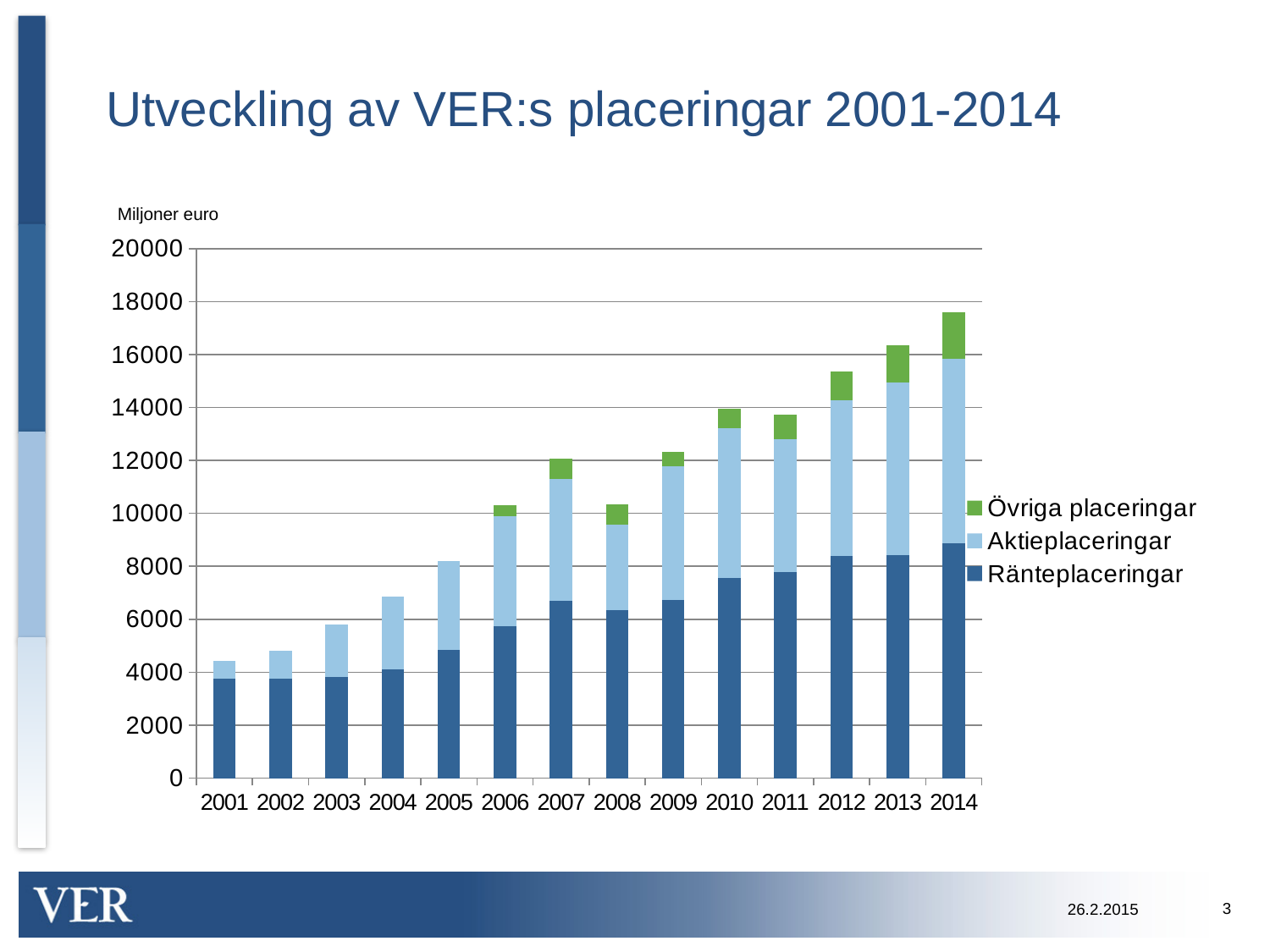
What unit is shown above the y axis of the chart? Miljoner euro Is the Ränteplaceringar value for 2014 greater or less than 8000? greater How many series does the chart's legend list? 3 Which year has the highest total bar in the chart? 2014 Is the total value for 2014 greater or less than 16000? greater How many years are shown along the x axis of the chart? 14 Is the total value for 2012 greater or less than 14000? greater Do the total values generally rise or fall from 2001 to 2014? rise Which year has the larger total bar, 2007 or 2008? 2007 Which year has the lowest total bar in the chart? 2001 What kind of chart is shown on the slide? Stacked bar chart